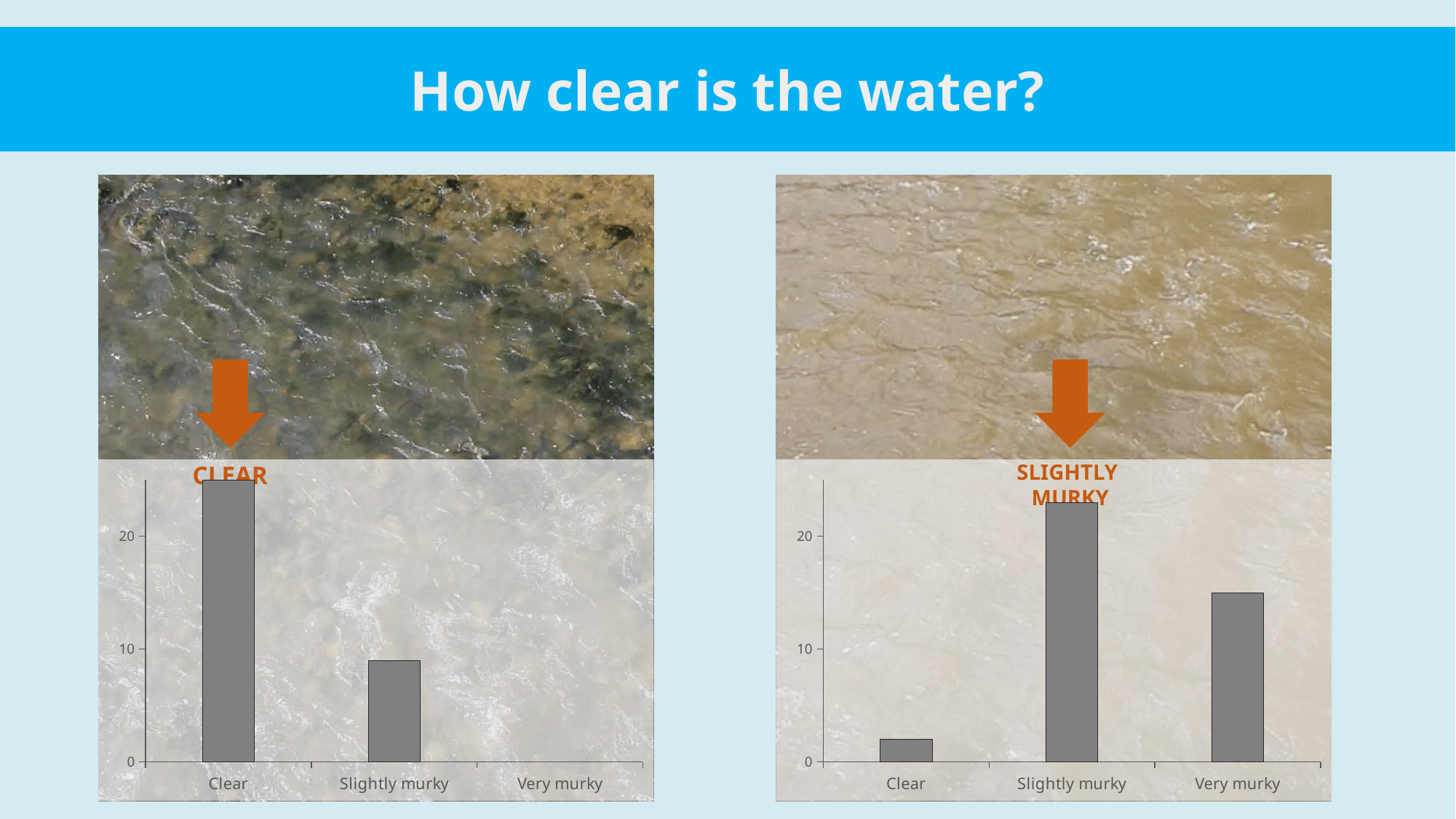
What label does the orange arrow above the right chart point to? SLIGHTLY MURKY In the right chart, is the value for Clear greater or less than 10? less In the left chart, is the value for Slightly murky greater or less than 10? less In the right chart, which is larger, the value for Slightly murky or the value for Very murky? Slightly murky What kind of chart is the left chart? bar chart In the right chart, is the value for Very murky greater or less than 10? greater In the right chart, which category has the highest bar? Slightly murky In the left chart, which is larger, the value for Clear or the value for Slightly murky? Clear In the left chart, which category has the highest bar? Clear In the right chart, which category has the lowest bar? Clear How many categories are on the x axis of the right chart? 3